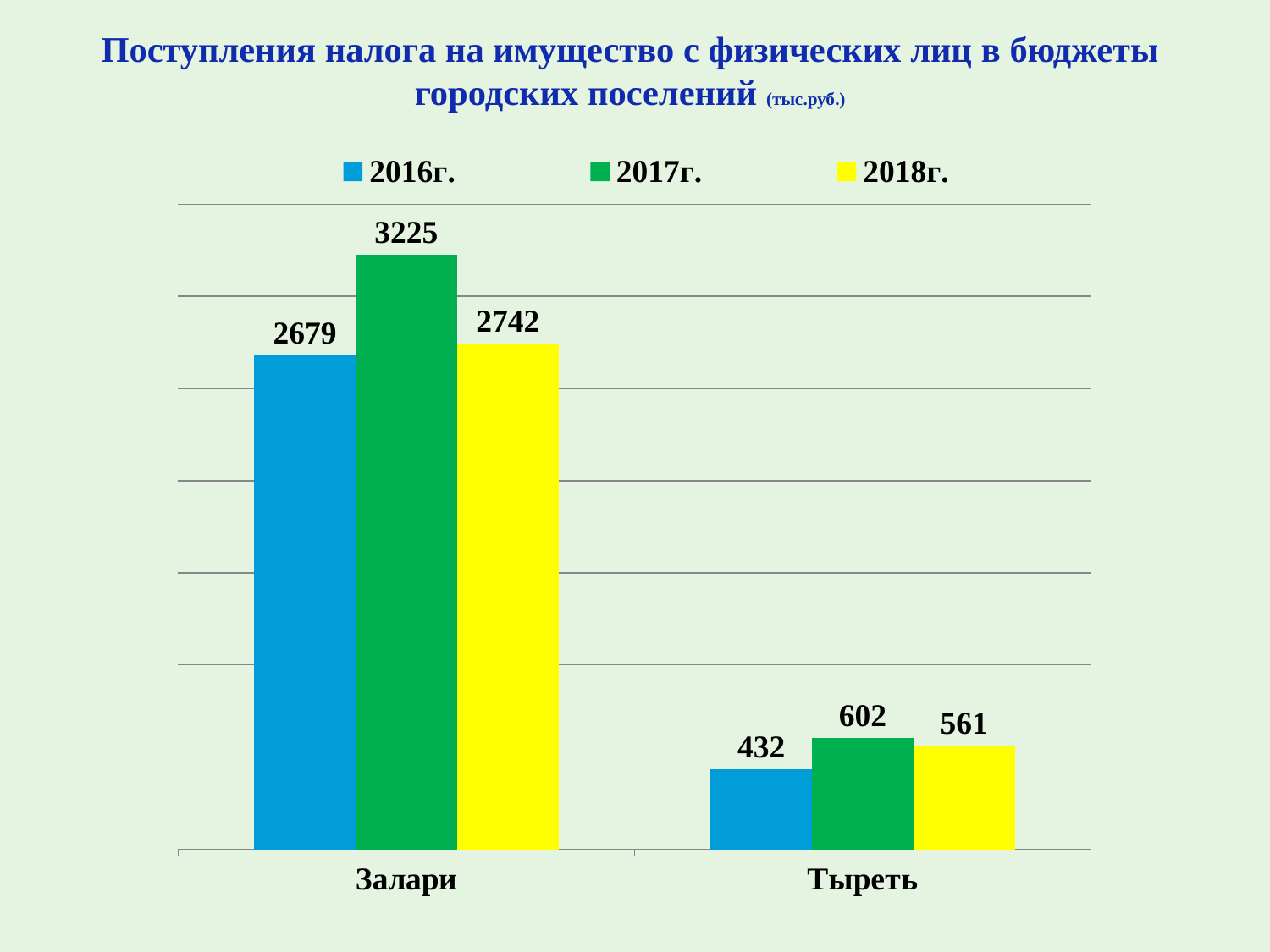
How many categories are shown on the x axis? 2 What is the value for Залари in 2018г.? 2742 What kind of chart is shown on the slide? bar chart What is the difference between the 2017г. and 2016г. values for Залари? 546 Which year has the lowest value for Залари? 2016г. Which year has the highest value for Тыреть? 2017г. What is the difference between the 2017г. and 2018г. values for Тыреть? 41 What unit is given in the chart title? тыс.руб. How many series does the legend list? 3 Which is larger: the 2018г. value for Залари or the 2018г. value for Тыреть? Залари What is the value for Залари in 2017г.? 3225 What is the value for Тыреть in 2016г.? 432